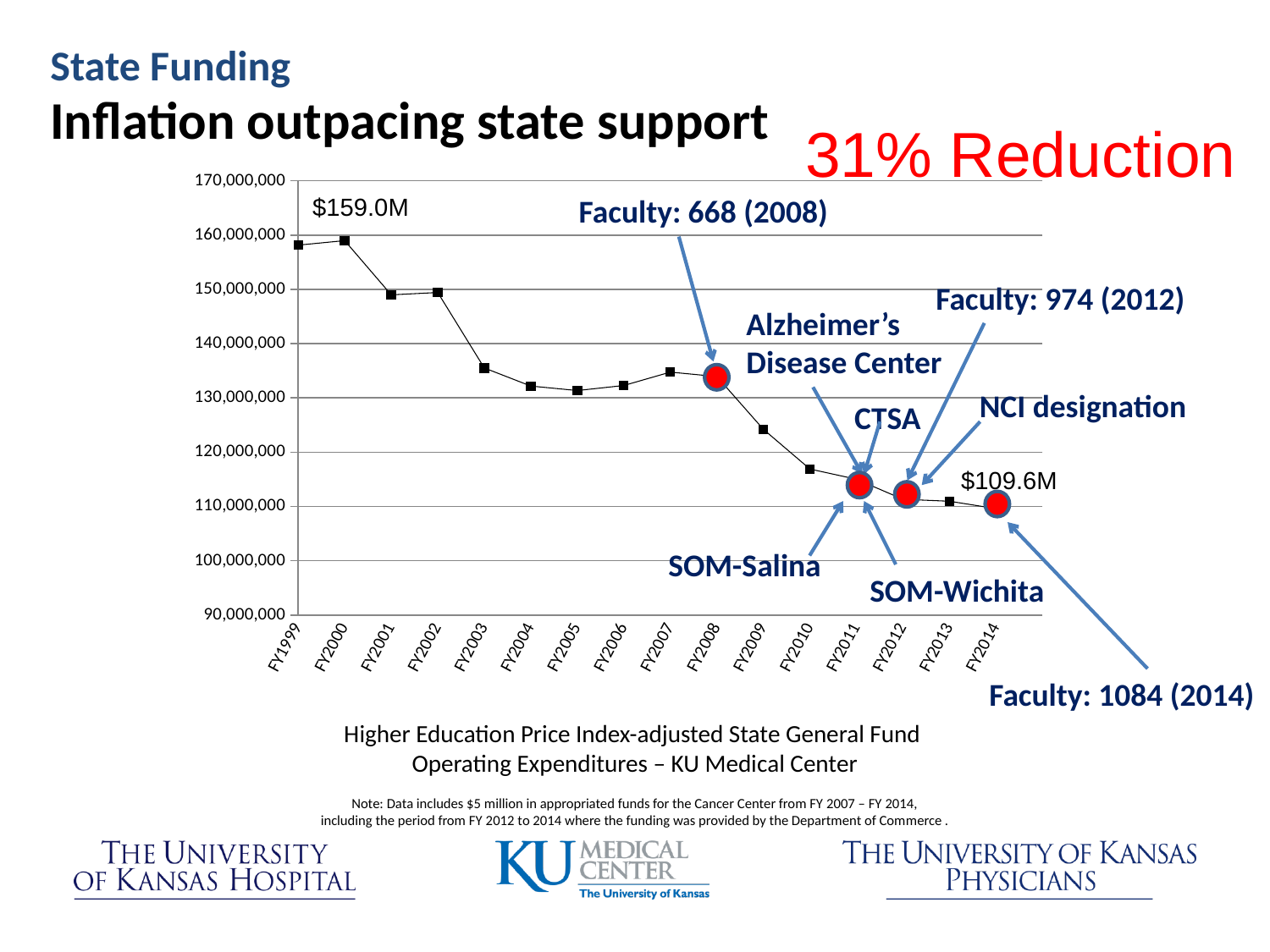
Do the plotted values generally rise or fall from FY1999 to FY2014? fall Is the value for FY2009 greater or less than 130,000,000? less According to the annotation, how many faculty were there in 2012? 974 Is the value for FY2005 greater or less than 140,000,000? less Is the value for FY2003 greater or less than 130,000,000? greater What kind of chart is shown on the slide? line chart What value is labelled for FY2014? $109.6M How many fiscal years are plotted on the x axis? 16 What value is labelled at the start of the series, near FY1999? $159.0M Which is larger, the value for FY2008 or the value for FY2012? FY2008 What percentage reduction is stated on the slide? 31% Reduction